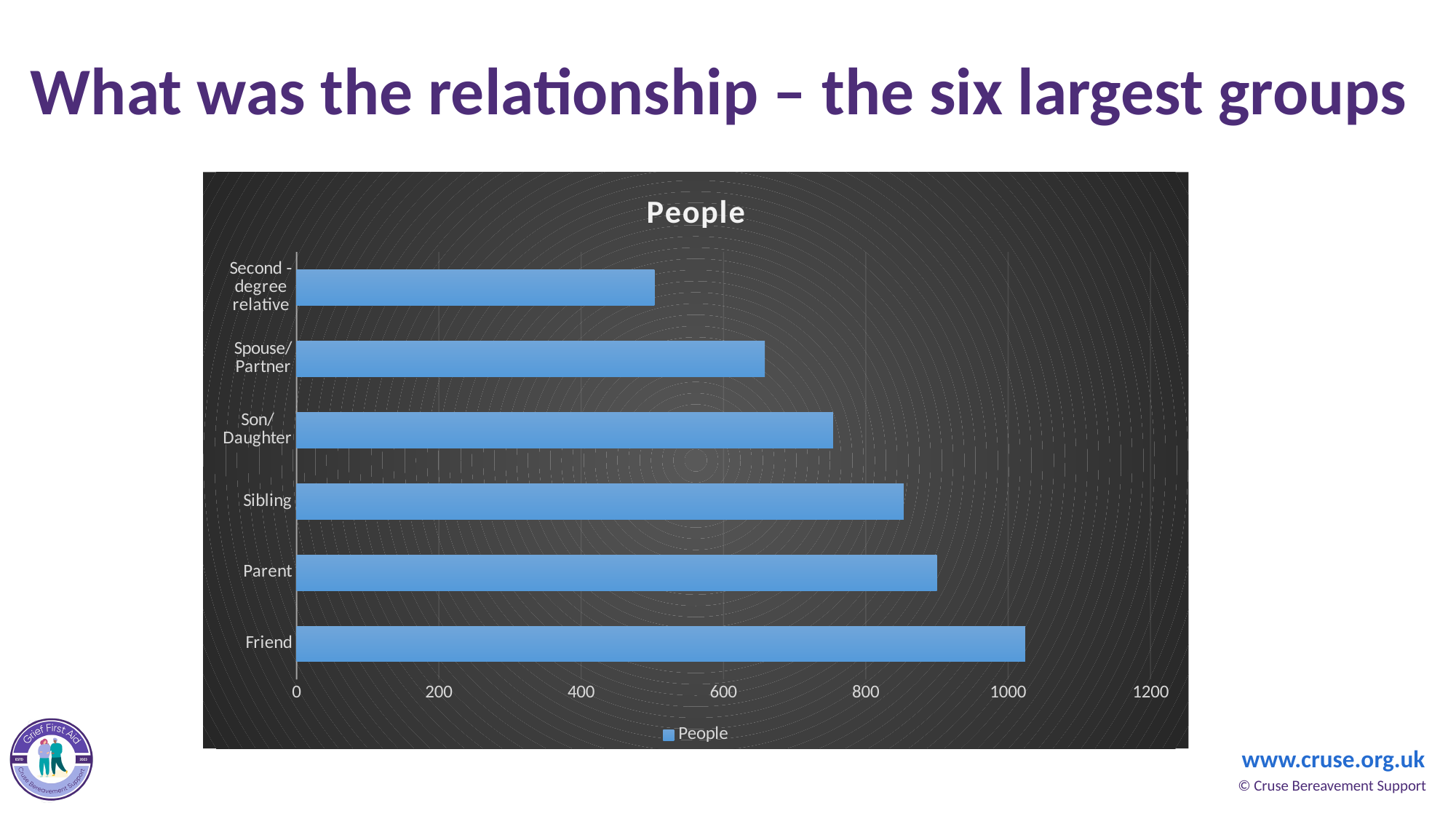
Which is larger, the value for Son/Daughter or the value for Spouse/Partner? Son/Daughter Is the value for Friend greater or less than 800? greater Which relationship group has the highest value in the People chart? Friend What is the title of the chart? People Which relationship group has the lowest value in the People chart? Second-degree relative How many series does the legend list? 1 Is the value for Spouse/Partner greater or less than 600? greater Which is larger, the value for Friend or the value for Parent? Friend How many relationship groups are shown in the chart? 6 Is the value for Second-degree relative greater or less than 600? less What kind of chart is shown on the slide? bar chart